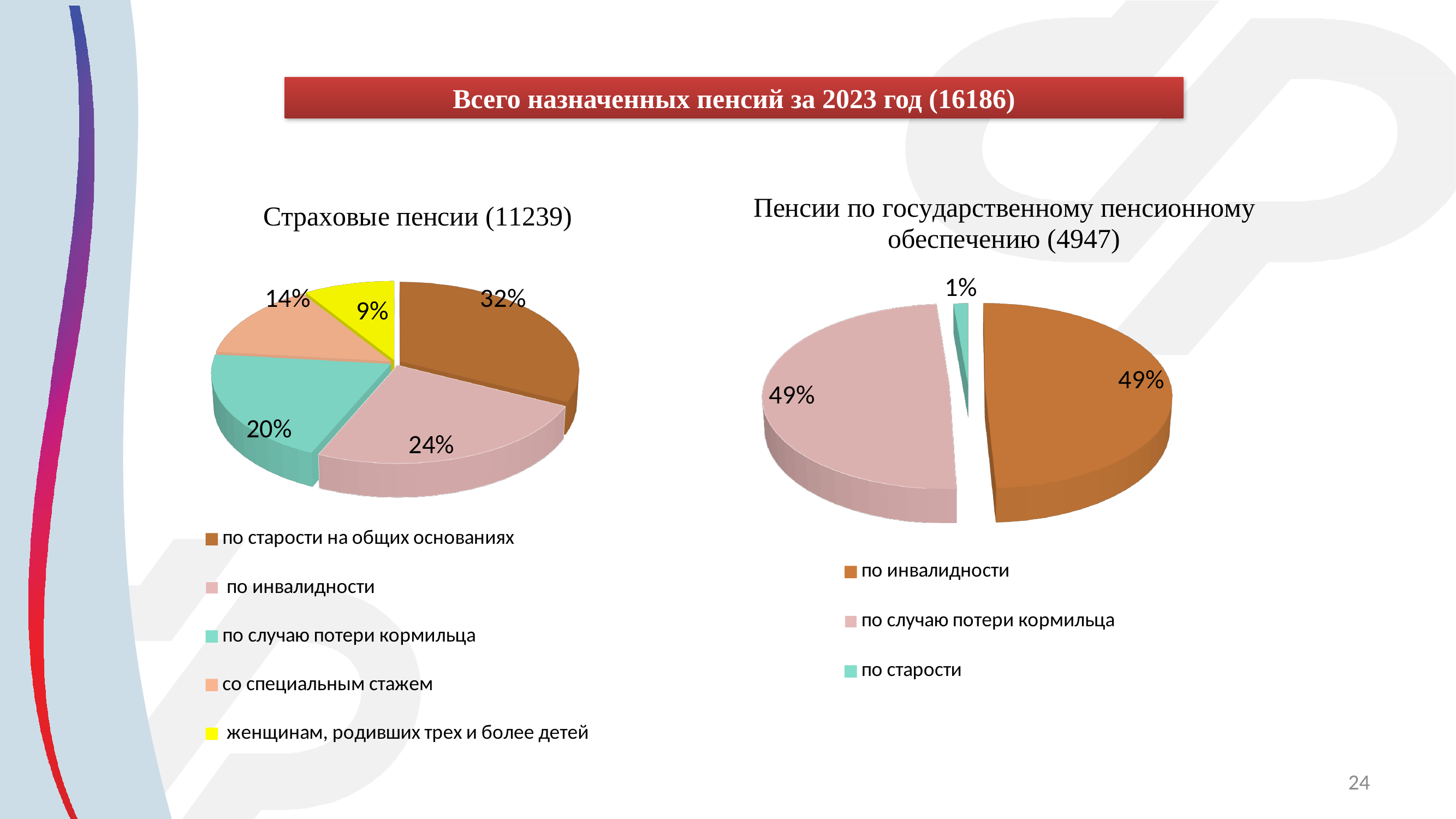
In the 'Страховые пенсии (11239)' chart, what share is 'по случаю потери кормильца'? 20% In the 'Страховые пенсии (11239)' chart, which category has the largest slice? по старости на общих основаниях In the 'Страховые пенсии (11239)' chart, which category has the smallest slice? женщинам, родивших трех и более детей How many categories does the 'Пенсии по государственному пенсионному обеспечению (4947)' chart show? 3 What kind of chart is the 'Страховые пенсии (11239)' chart? pie chart In the 'Страховые пенсии (11239)' chart, what share is 'по старости на общих основаниях'? 32% In the 'Страховые пенсии (11239)' chart, which is larger: 'по инвалидности' or 'по случаю потери кормильца'? по инвалидности How many categories does the 'Страховые пенсии (11239)' chart show? 5 In the 'Страховые пенсии (11239)' chart, what share is 'женщинам, родивших трех и более детей'? 9% In the 'Страховые пенсии (11239)' chart, what is the difference between the shares of 'по инвалидности' and 'со специальным стажем'? 10%